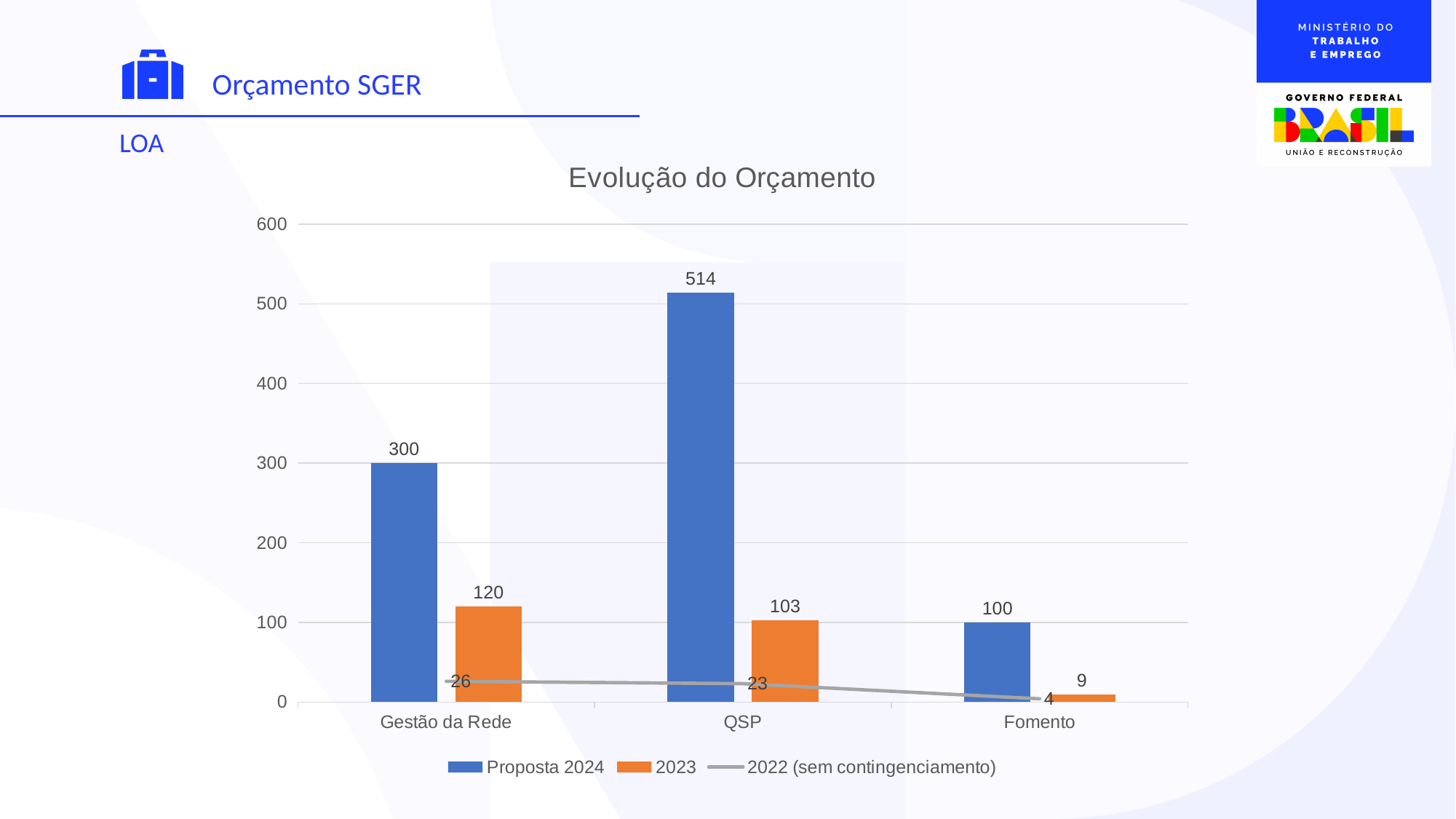
How many categories are shown on the x axis? 3 What is the difference between the Proposta 2024 and 2023 values for QSP? 411 What is the 2023 value for Gestão da Rede? 120 What is the 2022 (sem contingenciamento) value for Fomento? 4 What is the title of the chart? Evolução do Orçamento Is the Proposta 2024 value for Fomento greater or less than 200? less How many series does the legend list? 3 Which category has the highest Proposta 2024 value? QSP What kind of chart is used for the Proposta 2024 and 2023 series? bar chart What is the Proposta 2024 value for QSP? 514 Which category has the lowest 2023 value? Fomento Which is larger for Gestão da Rede: the Proposta 2024 value or the 2023 value? Proposta 2024